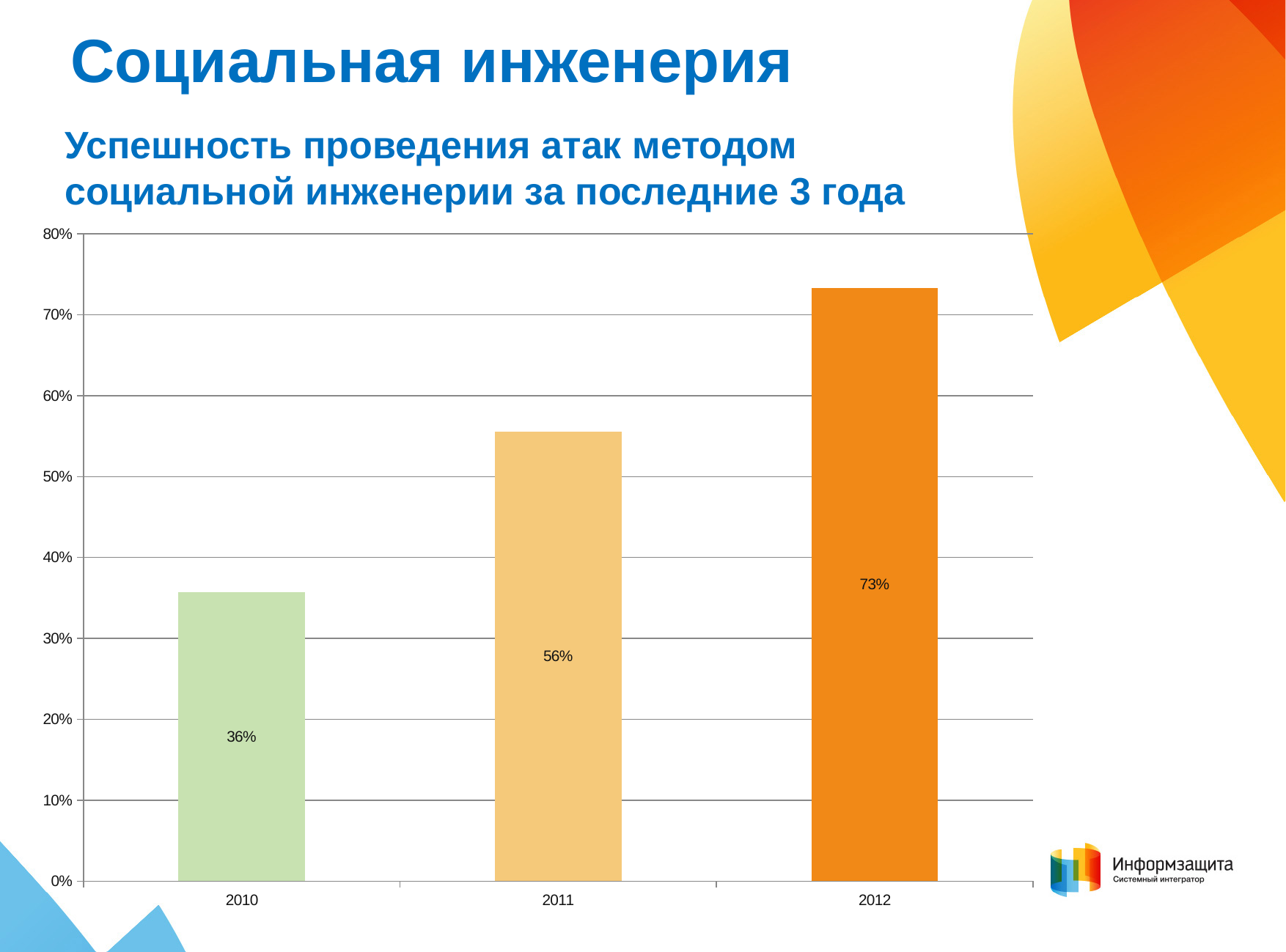
What is the difference between the values for 2012 and 2010? 37% What is the value for 2011? 56% Is the value for 2011 greater or less than 50%? greater What is the value for 2012? 73% Which year has the lowest value? 2010 Which year has the highest value? 2012 How many years are shown on the x axis? 3 What kind of chart is shown on the slide? Bar chart What is the difference between the values for 2011 and 2010? 20% Which is larger, the value for 2011 or the value for 2012? 2012 Do the values rise or fall from 2010 to 2012? Rise What is the value for 2010? 36%